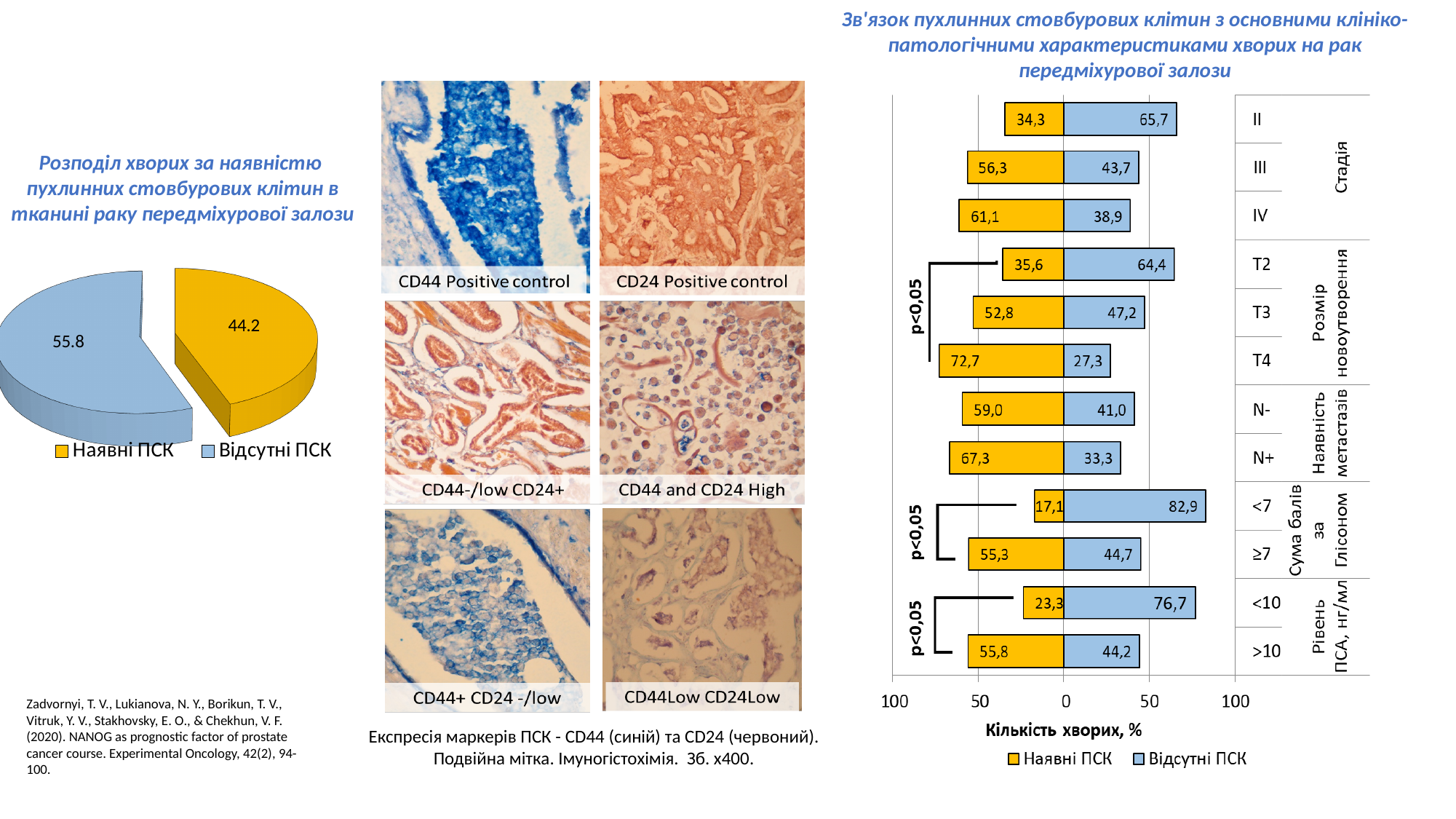
In the bar chart on the right, what is the Відсутні ПСК value for category <7? 82,9 In the bar chart on the right, what is the Наявні ПСК value for category T4? 72,7 In the bar chart on the right, what is the difference between the Наявні ПСК values for >10 and <10? 32,5 What kind of chart is the chart on the left of the slide? Pie chart In the bar chart on the right, which category has the highest Відсутні ПСК value? <7 What is the x-axis title of the bar chart on the right? Кількість хворих, % In the bar chart on the right, which is larger, the Наявні ПСК value for N+ or for N-? N+ In the bar chart on the right, which category has the lowest Наявні ПСК value? <7 How many series does the legend of the bar chart on the right list? 2 In the pie chart on the left, which slice is larger, Наявні ПСК or Відсутні ПСК? Відсутні ПСК How many categories are shown in the bar chart on the right? 12 In the pie chart on the left, what is the value for Наявні ПСК? 44.2